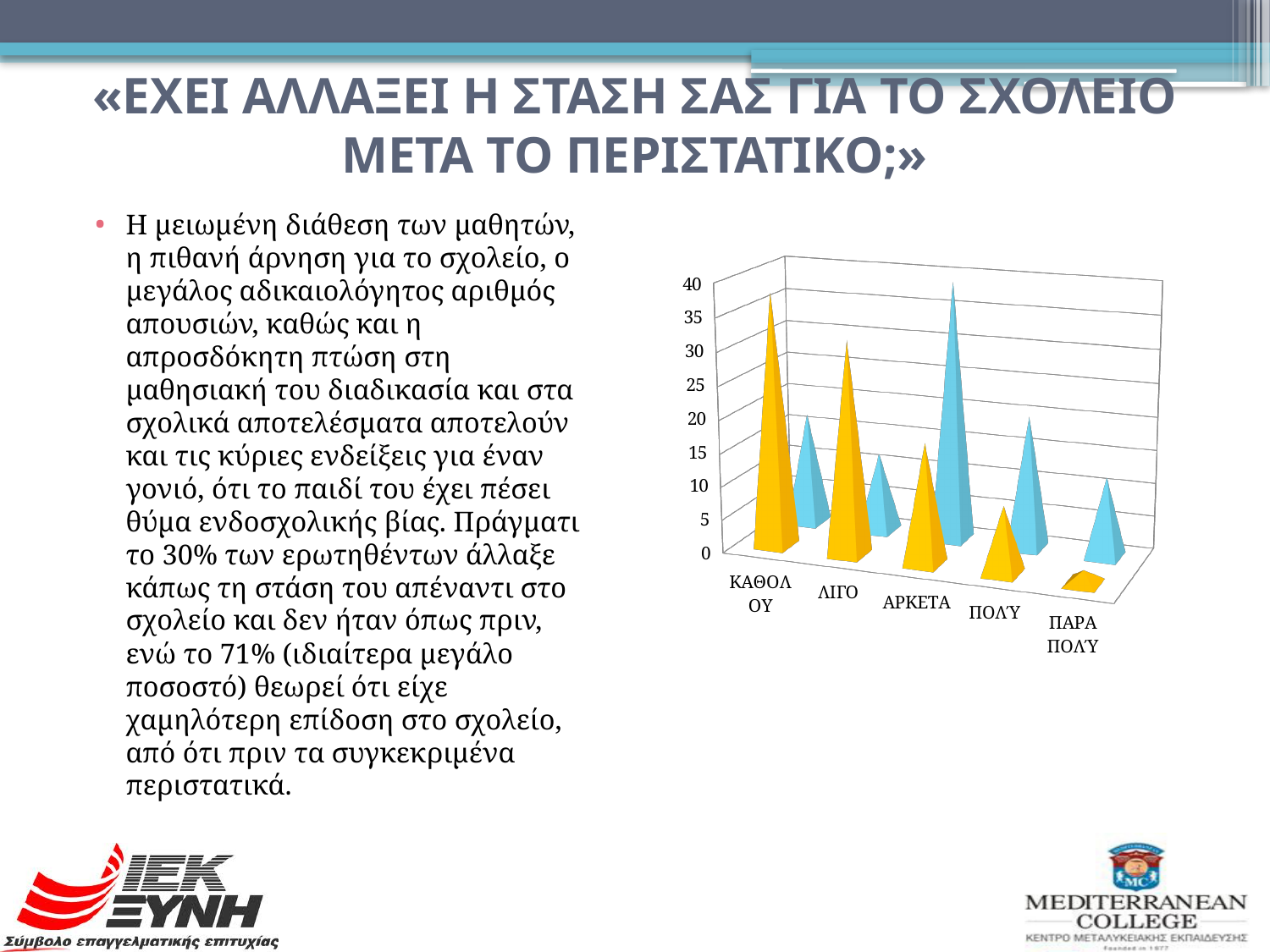
What kind of chart is shown on the slide? bar chart How many categories are shown on the x axis of the chart? 5 What two colours are used for the bars in the chart? yellow and blue Which category has the tallest yellow bar? ΚΑΘΟΛΟΥ Is the yellow bar for ΑΡΚΕΤΑ greater or less than 20? less Do the yellow bars rise or fall from ΚΑΘΟΛΟΥ to ΠΑΡΑ ΠΟΛΥ? fall Which is larger, the yellow bar for ΚΑΘΟΛΟΥ or the yellow bar for ΛΙΓΟ? ΚΑΘΟΛΟΥ Is the yellow bar for ΚΑΘΟΛΟΥ greater or less than 30? greater Which category has the shortest yellow bar? ΠΑΡΑ ΠΟΛΥ Which category has the tallest blue bar? ΑΡΚΕΤΑ Is the blue bar for ΑΡΚΕΤΑ greater or less than 30? greater